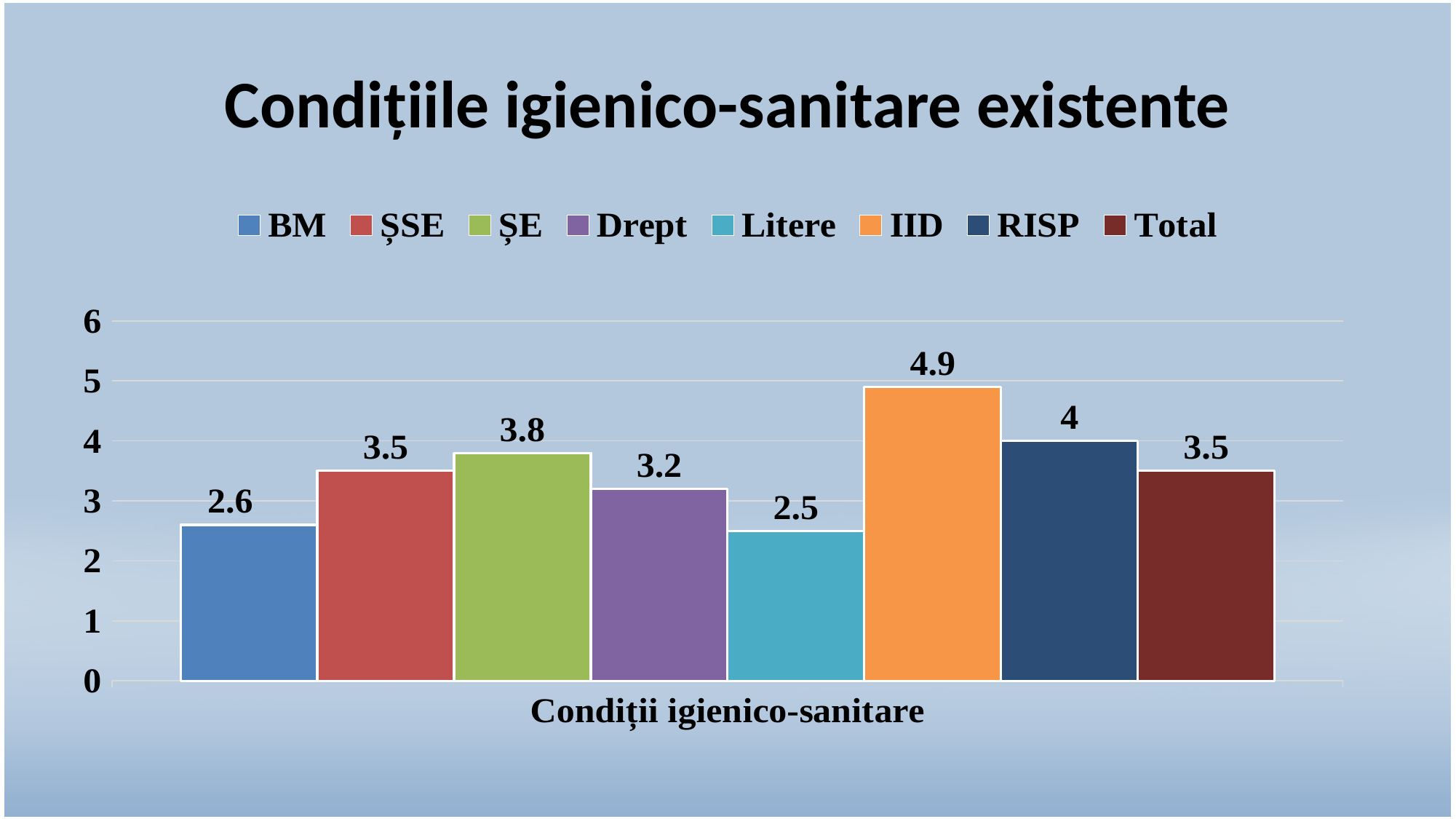
How many series does the legend list? 8 What is the value for IID? 4.9 Which is larger, the value for ȘSE or the value for Drept? ȘSE Which series has the highest value? IID What is the value for Total? 3.5 What is the difference between the values for IID and Litere? 2.4 Which series has the lowest value? Litere What is the value for Drept? 3.2 What is the difference between the values for RISP and ȘE? 0.2 What is the value for BM? 2.6 What is the title of the chart? Condițiile igienico-sanitare existente What kind of chart is shown on the slide? Bar chart